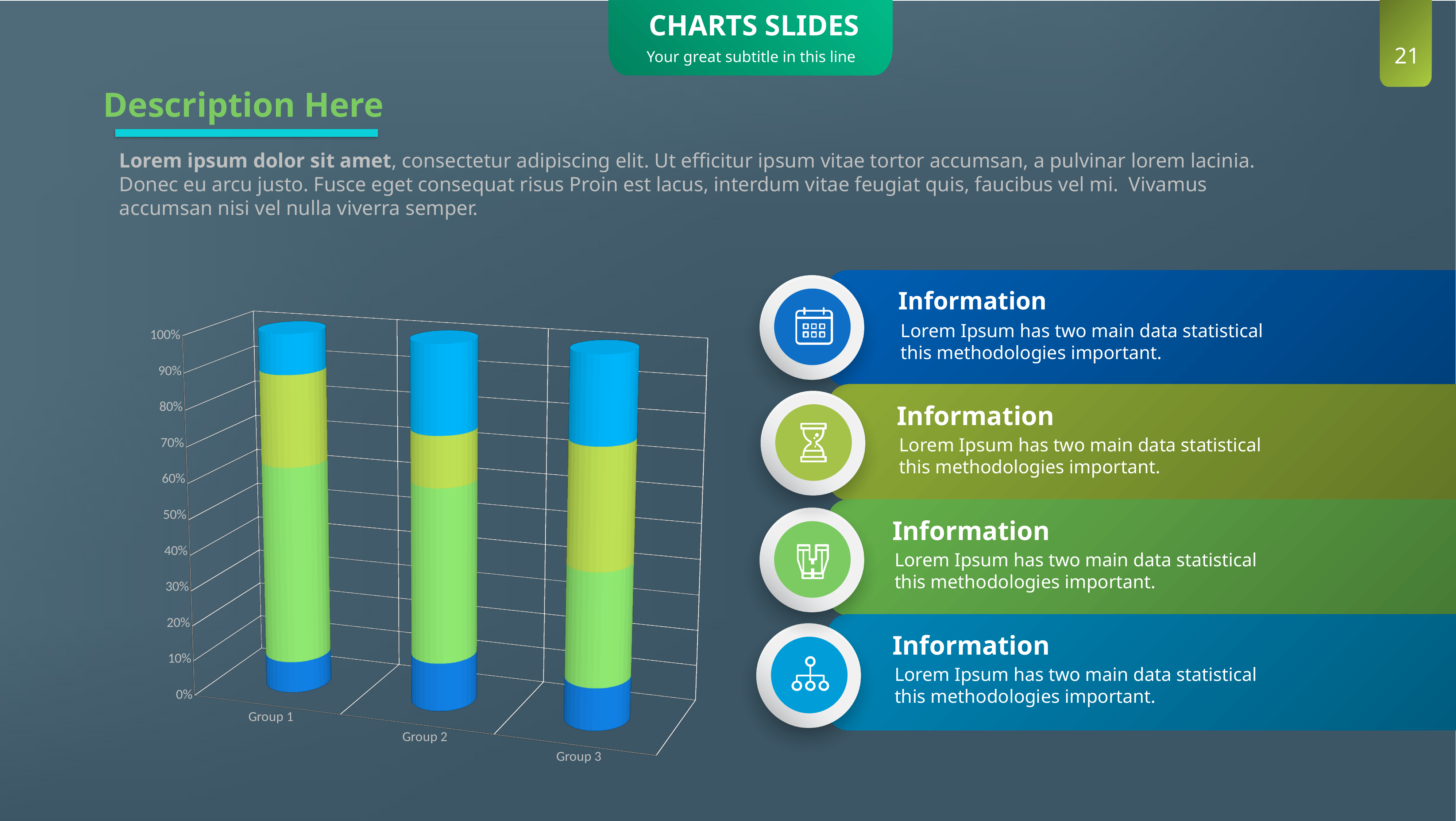
What is the label of the first category on the chart's x axis? Group 1 How many stacked segments does each bar in the chart have? 4 What kind of chart is shown on the slide? bar chart What is the highest tick value shown on the chart's vertical axis? 100% What is the label of the last category on the chart's x axis? Group 3 How many categories are plotted on the chart's x axis? 3 What colour is the bottom segment of each bar in the chart? dark blue What is the lowest tick value shown on the chart's vertical axis? 0%